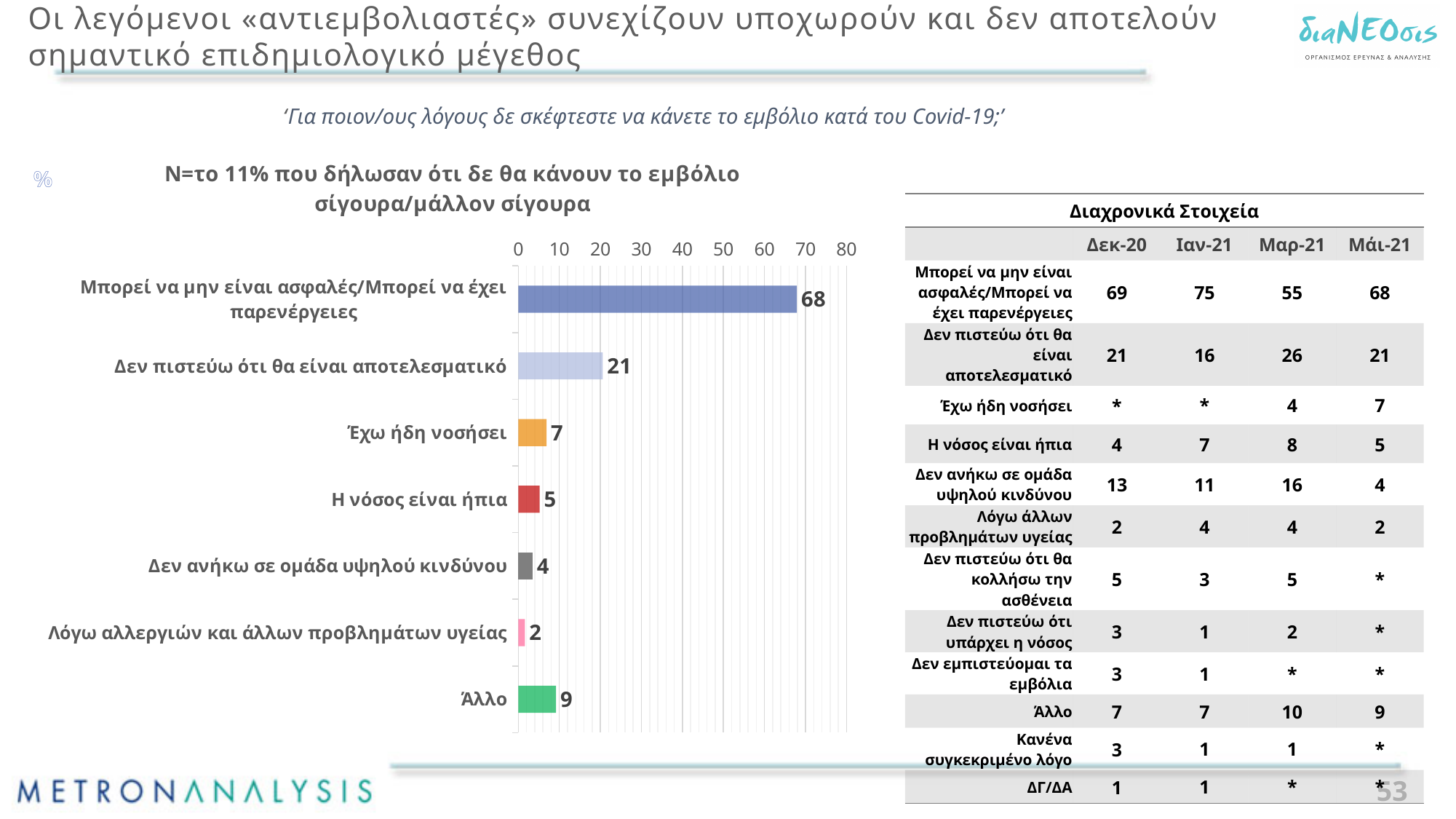
What is the value for 'Άλλο' in the bar chart? 9 What kind of chart is shown on the slide? bar chart What is the value for 'Δεν πιστεύω ότι θα είναι αποτελεσματικό' in the bar chart? 21 How many categories are shown in the bar chart? 7 Which category has the lowest value in the bar chart? Λόγω αλλεργιών και άλλων προβλημάτων υγείας Is the value for 'Δεν πιστεύω ότι θα είναι αποτελεσματικό' greater or less than 30? less What is the difference between the values for 'Μπορεί να μην είναι ασφαλές/Μπορεί να έχει παρενέργειες' and 'Δεν πιστεύω ότι θα είναι αποτελεσματικό'? 47 What is the value for 'Έχω ήδη νοσήσει' in the bar chart? 7 What is the value for 'Μπορεί να μην είναι ασφαλές/Μπορεί να έχει παρενέργειες' in the bar chart? 68 Which is larger in the bar chart: 'Η νόσος είναι ήπια' or 'Άλλο'? Άλλο What is the value for 'Δεν ανήκω σε ομάδα υψηλού κινδύνου' in the bar chart? 4 Which category has the highest value in the bar chart? Μπορεί να μην είναι ασφαλές/Μπορεί να έχει παρενέργειες